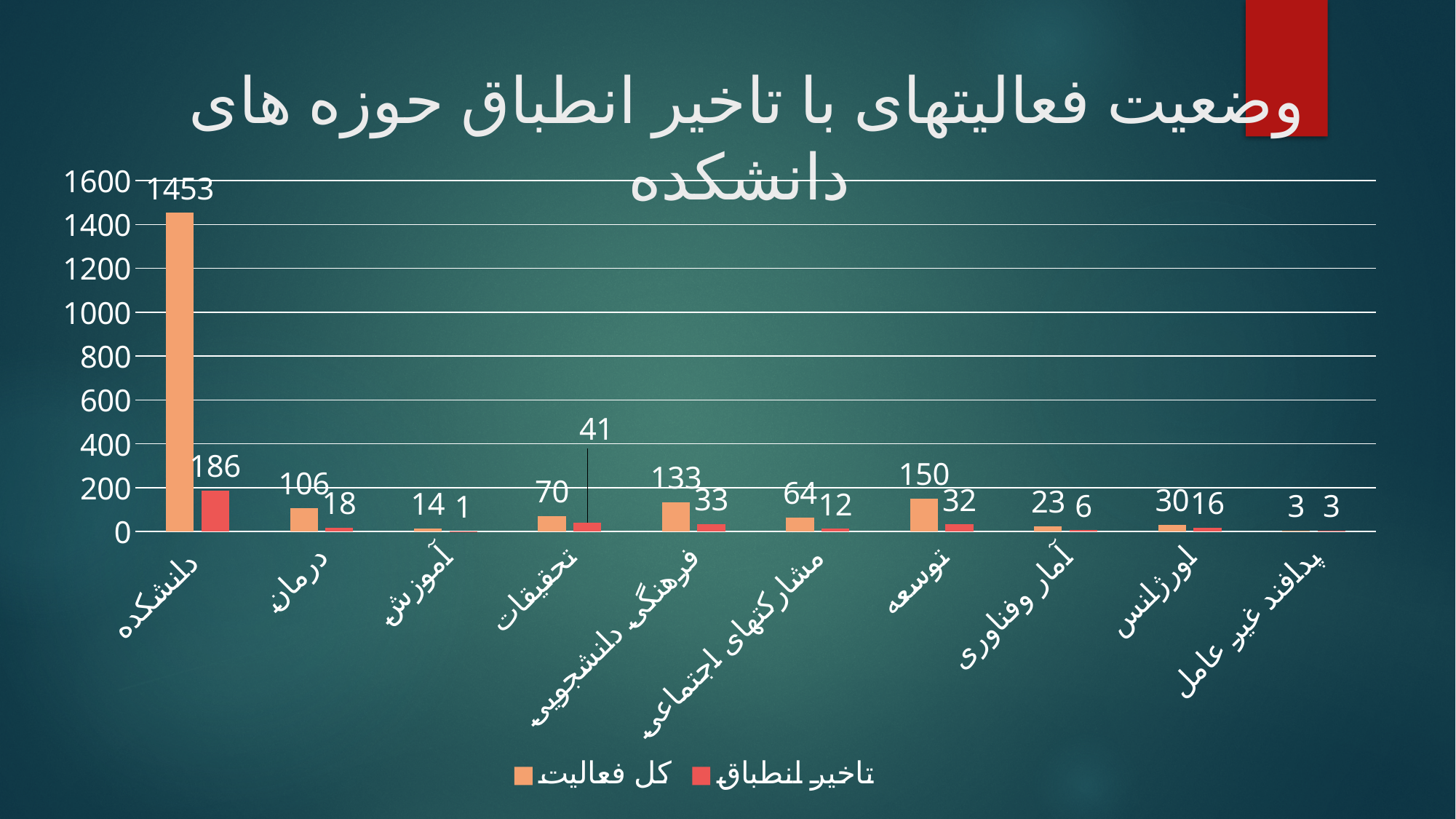
What is the difference between کل فعالیت and تاخیر انطباق for درمان? 88 Which is larger, the کل فعالیت value for فرهنگی دانشجویی or for توسعه? توسعه How many series does the legend list? 2 Is the کل فعالیت value for دانشکده greater or less than 1400? greater What kind of chart is shown on the slide? bar chart What is the value of کل فعالیت for توسعه? 150 Which colour represents the تاخیر انطباق series? red Which category has the highest کل فعالیت value? دانشکده Which category has the lowest کل فعالیت value? پدافند غیر عامل What is the value of کل فعالیت for دانشکده? 1453 How many categories are shown on the x axis? 10 What is the value of تاخیر انطباق for تحقیقات? 41